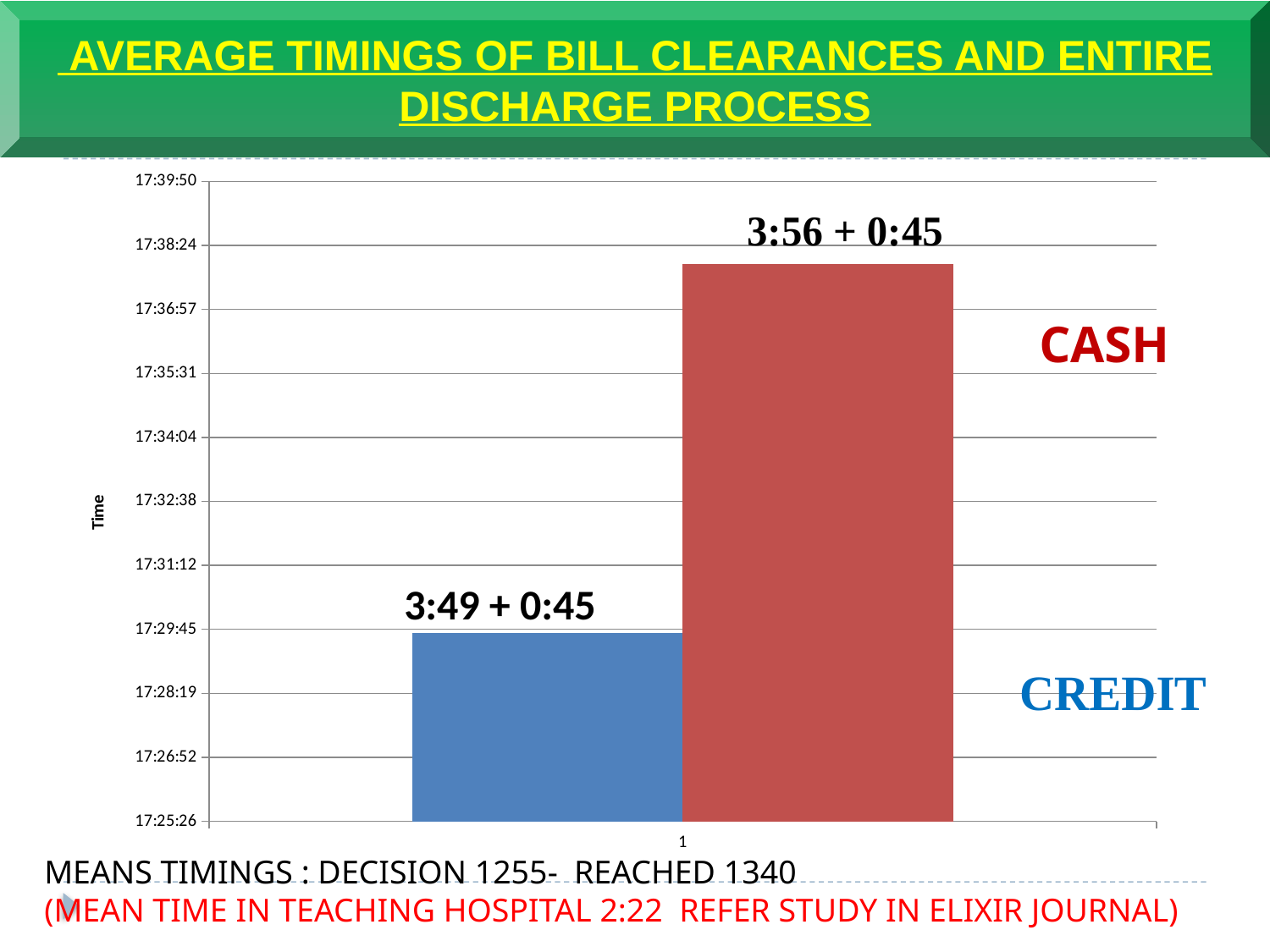
What is the lowest tick value shown on the vertical axis? 17:25:26 Is the top of the CASH bar greater or less than 17:36:57 on the time axis? greater What kind of chart is shown on the slide? bar chart What label is printed above the CASH bar? 3:56 + 0:45 Which category has the lowest bar? CREDIT How many bars are plotted in the chart? 2 What is the title of the chart on the slide? AVERAGE TIMINGS OF BILL CLEARANCES AND ENTIRE DISCHARGE PROCESS Which bar is taller, CASH or CREDIT? CASH What is the label of the vertical axis? Time What label is printed above the CREDIT bar? 3:49 + 0:45 Which category has the highest bar? CASH Is the top of the CREDIT bar greater or less than 17:31:12 on the time axis? less